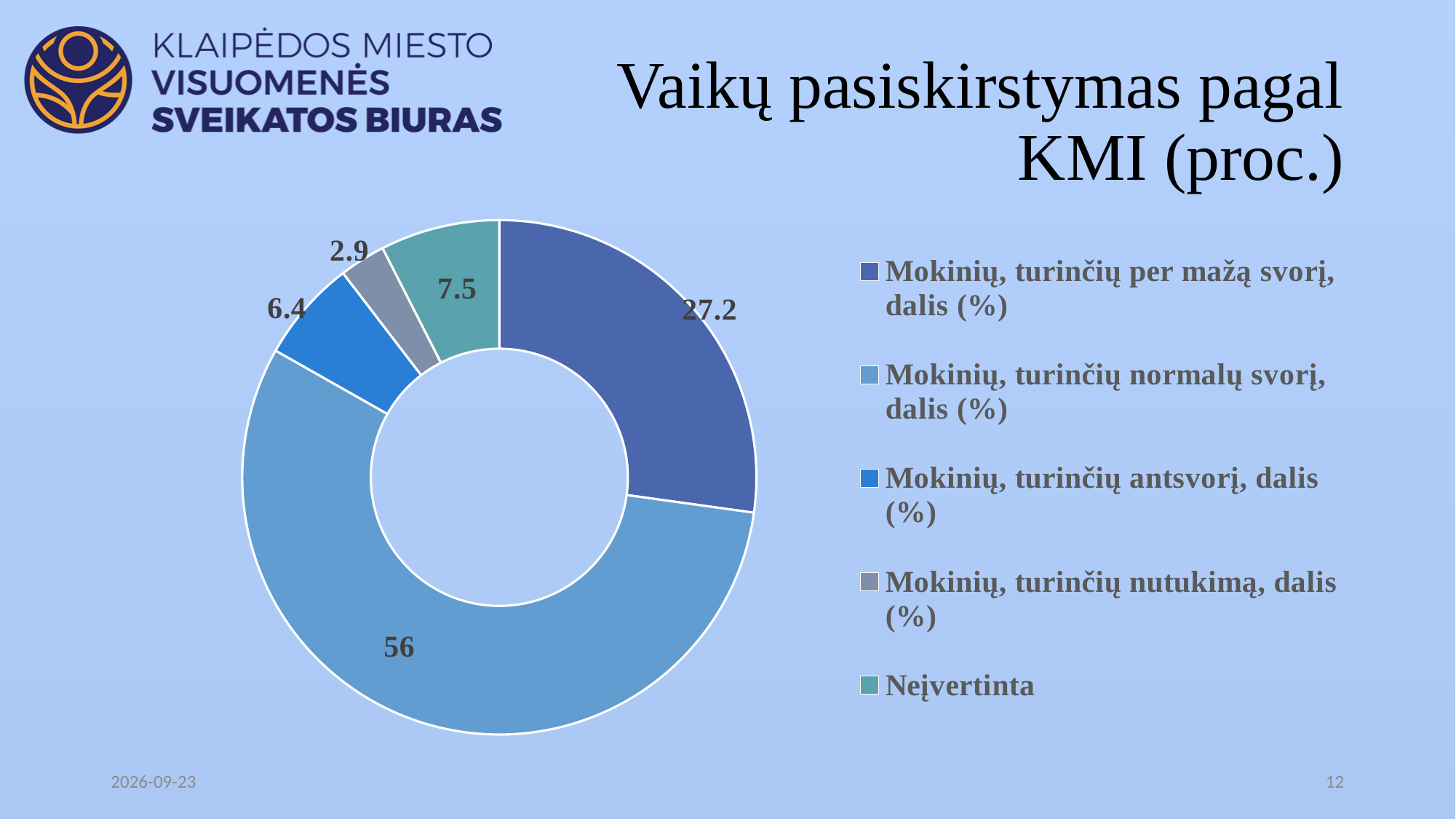
What is the difference between the values for "Mokinių, turinčių normalų svorį, dalis (%)" and "Mokinių, turinčių per mažą svorį, dalis (%)"? 28.8 What kind of chart is shown on the slide? Doughnut (pie) chart What value is shown for the slice "Mokinių, turinčių normalų svorį, dalis (%)"? 56 Which category has the largest slice in the chart? Mokinių, turinčių normalų svorį, dalis (%) Which is larger: the slice for "Mokinių, turinčių antsvorį, dalis (%)" or the slice for "Neįvertinta"? Neįvertinta What value is shown for the slice "Mokinių, turinčių per mažą svorį, dalis (%)"? 27.2 What value is shown for the slice "Neįvertinta"? 7.5 How many slices does the chart have? 5 What value is shown for the slice "Mokinių, turinčių antsvorį, dalis (%)"? 6.4 Which category has the smallest slice in the chart? Mokinių, turinčių nutukimą, dalis (%) What is the title of the chart on the slide? Vaikų pasiskirstymas pagal KMI (proc.) What is the difference between the values for "Neįvertinta" and "Mokinių, turinčių antsvorį, dalis (%)"? 1.1